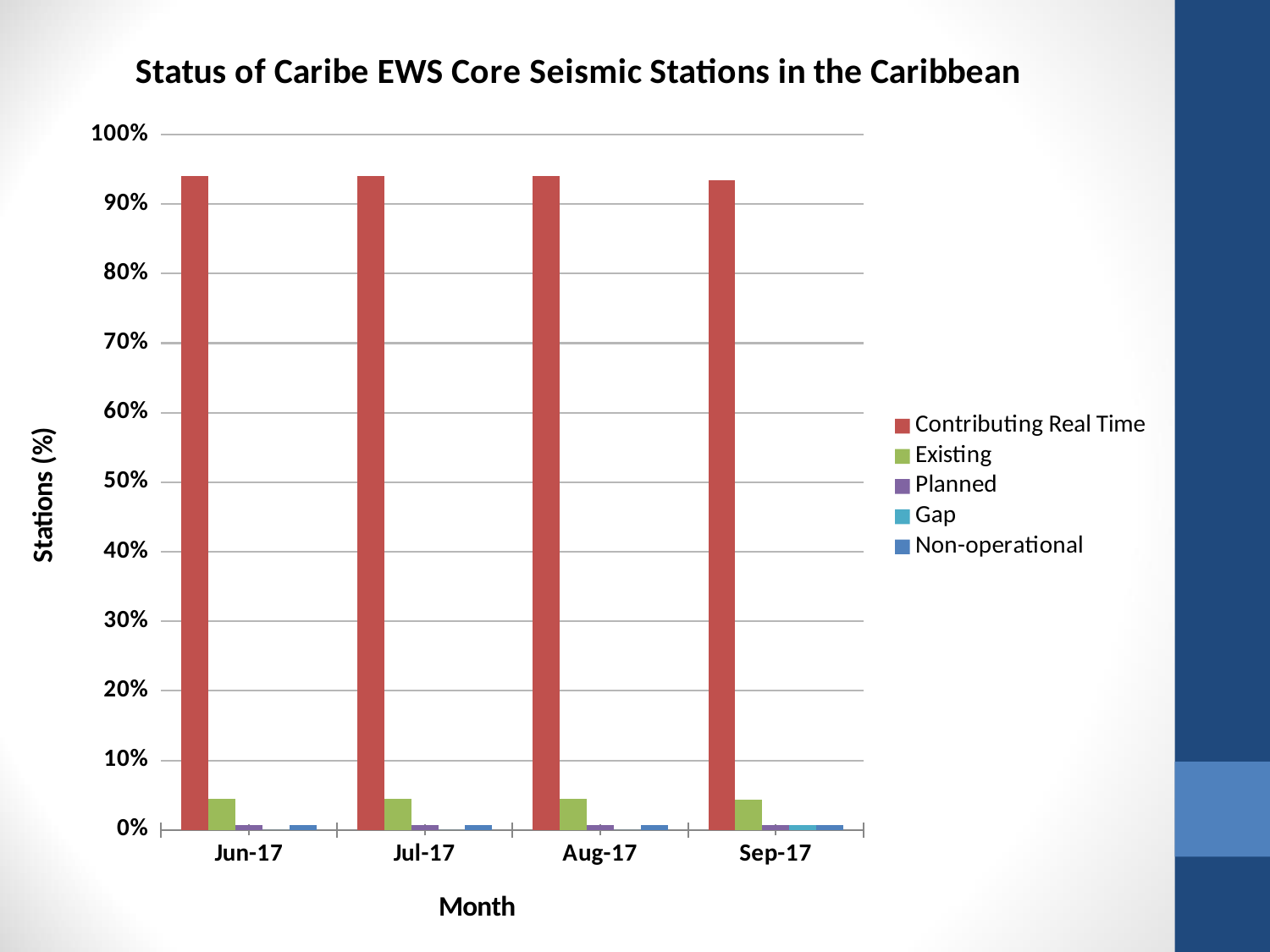
What is the title of the chart? Status of Caribe EWS Core Seismic Stations in the Caribbean In which month is the Gap series highest? Sep-17 How many series does the legend list? 5 Which series has the highest value in Jun-17? Contributing Real Time Is the value for Existing in Aug-17 greater or less than 10%? less What kind of chart is shown on the slide? Bar chart Is the value for Contributing Real Time in Jul-17 greater or less than 90%? greater Which is larger in Sep-17, Contributing Real Time or Existing? Contributing Real Time Is the value for Non-operational in Sep-17 greater or less than 10%? less How many months are shown on the x axis? 4 Which is larger in Jun-17, Existing or Planned? Existing What is the label of the y axis? Stations (%)